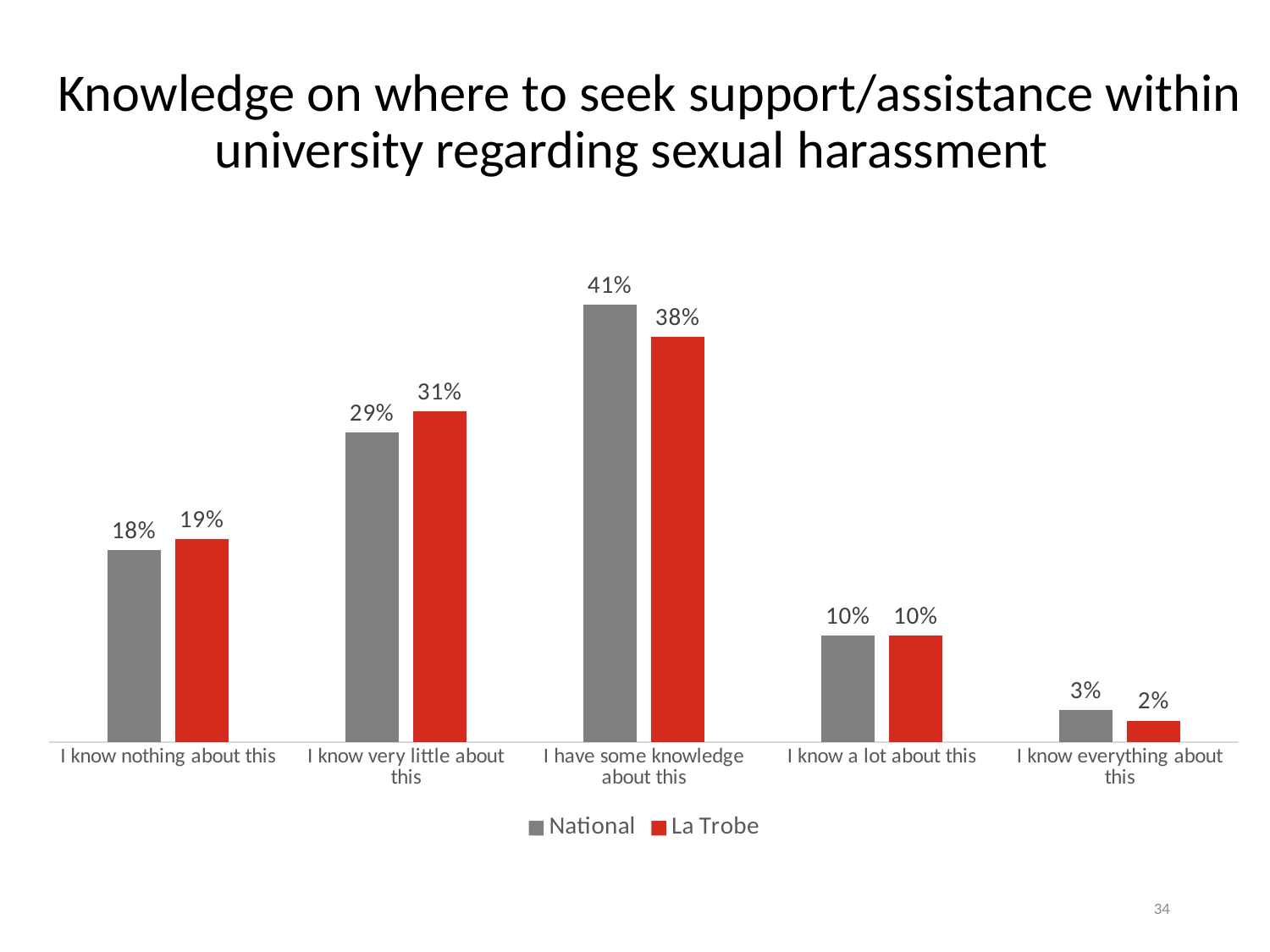
Which category has the lowest La Trobe value? I know everything about this What is the National value for "I have some knowledge about this"? 41% For "I know nothing about this", which is larger: the National value or the La Trobe value? La Trobe How many categories are shown on the x axis? 5 What is the difference between the National and La Trobe values for "I know very little about this"? 2% Which colour represents the La Trobe series? Red How many series does the legend list? 2 What is the La Trobe value for "I know very little about this"? 31% What kind of chart is shown on the slide? Bar chart Which category has the highest National value? I have some knowledge about this What is the La Trobe value for "I know everything about this"? 2% What is the difference between the National and La Trobe values for "I have some knowledge about this"? 3%